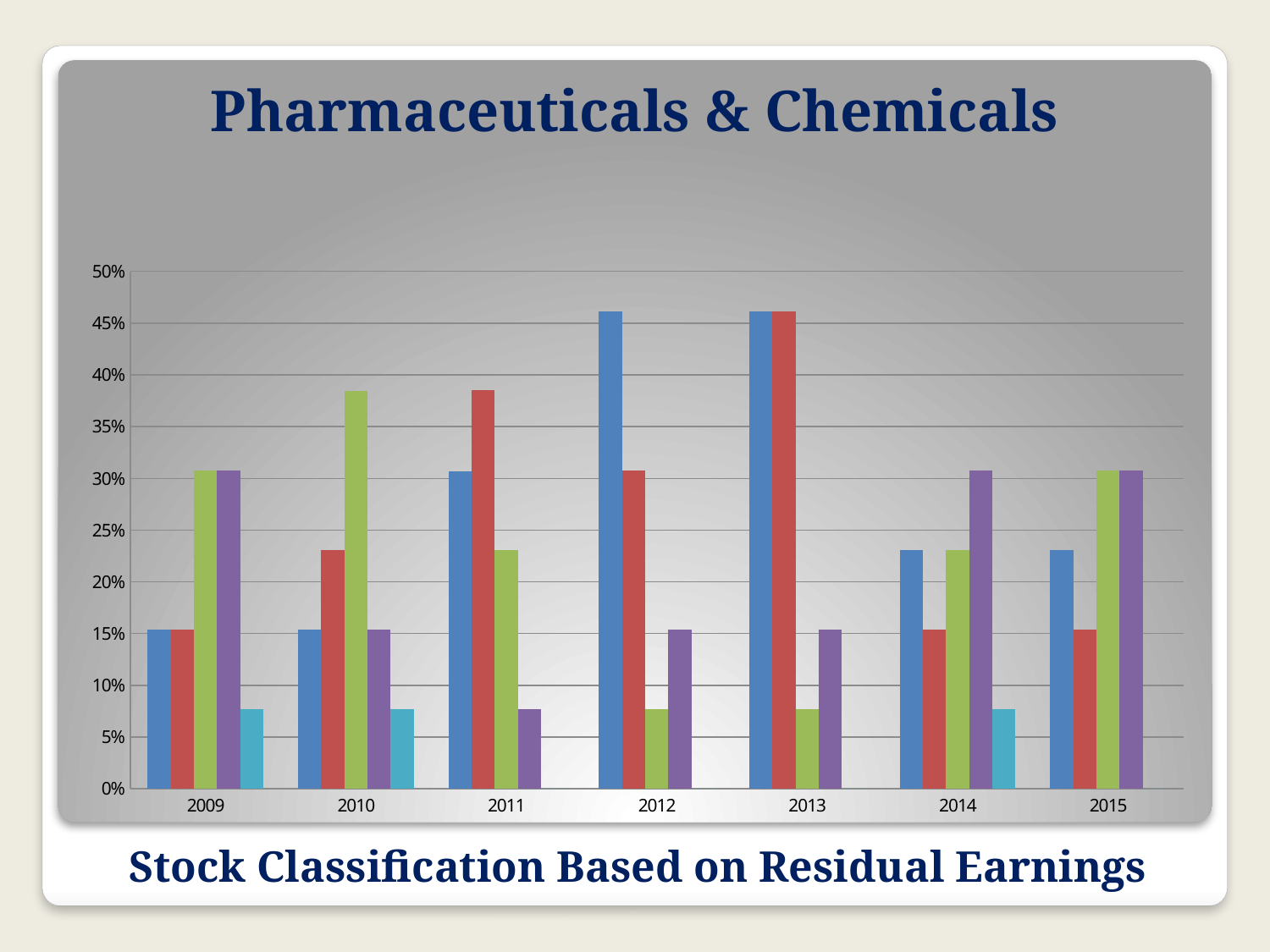
What is the title of the chart? Pharmaceuticals & Chemicals Is the value of the purple bar for 2015 greater or less than 25%? greater Is the value of the red bar for 2011 greater or less than 35%? greater In which year is the green bar the tallest? 2010 For 2011, which is larger, the blue bar or the red bar? The red bar In which year is the purple bar the shortest? 2011 What is the highest value shown on the y axis? 50% Is the value of the blue bar for 2012 greater or less than 40%? greater What kind of chart is shown on the slide? Bar chart For 2014, which is larger, the blue bar or the purple bar? The purple bar How many years are shown along the x axis of the chart? 7